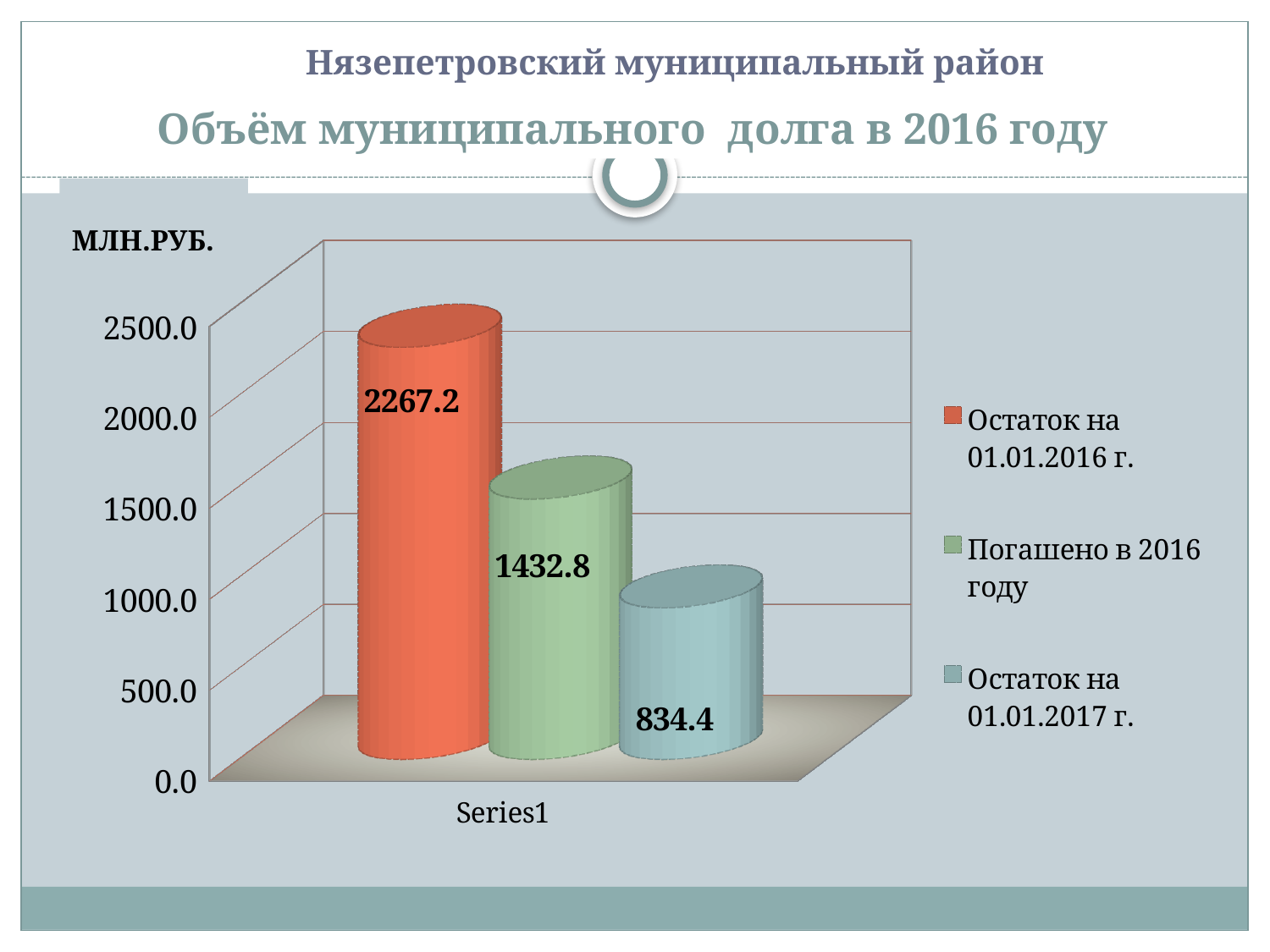
What is the difference between "Погашено в 2016 году" and "Остаток на 01.01.2017 г."? 598.4 What kind of chart is shown on the slide? Bar chart What is the value for "Остаток на 01.01.2017 г."? 834.4 Which is larger: "Погашено в 2016 году" or "Остаток на 01.01.2017 г."? Погашено в 2016 году What unit is shown on the vertical axis label? МЛН.РУБ. What is the value for "Погашено в 2016 году"? 1432.8 Which series has the highest value? Остаток на 01.01.2016 г. How many series does the legend list? 3 What is the difference between "Остаток на 01.01.2016 г." and "Остаток на 01.01.2017 г."? 1432.8 What is the value for "Остаток на 01.01.2016 г."? 2267.2 Is the value for "Остаток на 01.01.2016 г." greater or less than 2000.0? greater Which series has the lowest value? Остаток на 01.01.2017 г.